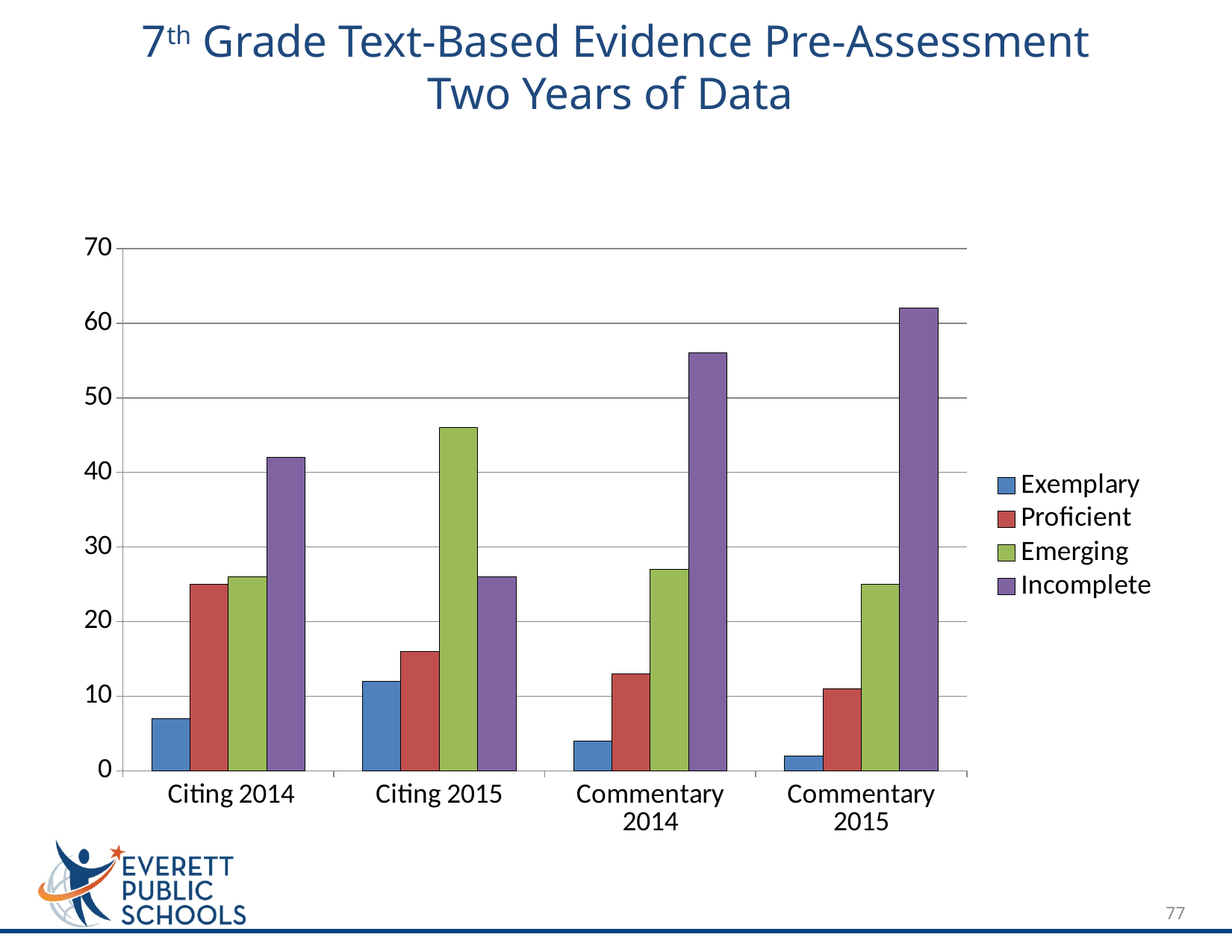
How many categories are shown on the x axis? 4 Which category has the highest Incomplete value? Commentary 2015 How many series does the legend list? 4 Is the Incomplete value for Commentary 2015 greater or less than 60? greater Which is larger, the Exemplary value for Citing 2014 or for Citing 2015? Citing 2015 Which is larger, the Incomplete value for Citing 2014 or for Citing 2015? Citing 2014 What kind of chart is shown on the slide? Bar chart Is the Proficient value for Citing 2014 greater or less than 20? greater What colour represents the Incomplete series in the legend? Purple Which category has the lowest Exemplary value? Commentary 2015 Is the Emerging value for Citing 2015 greater or less than 40? greater Which series has the highest value in the Citing 2015 category? Emerging